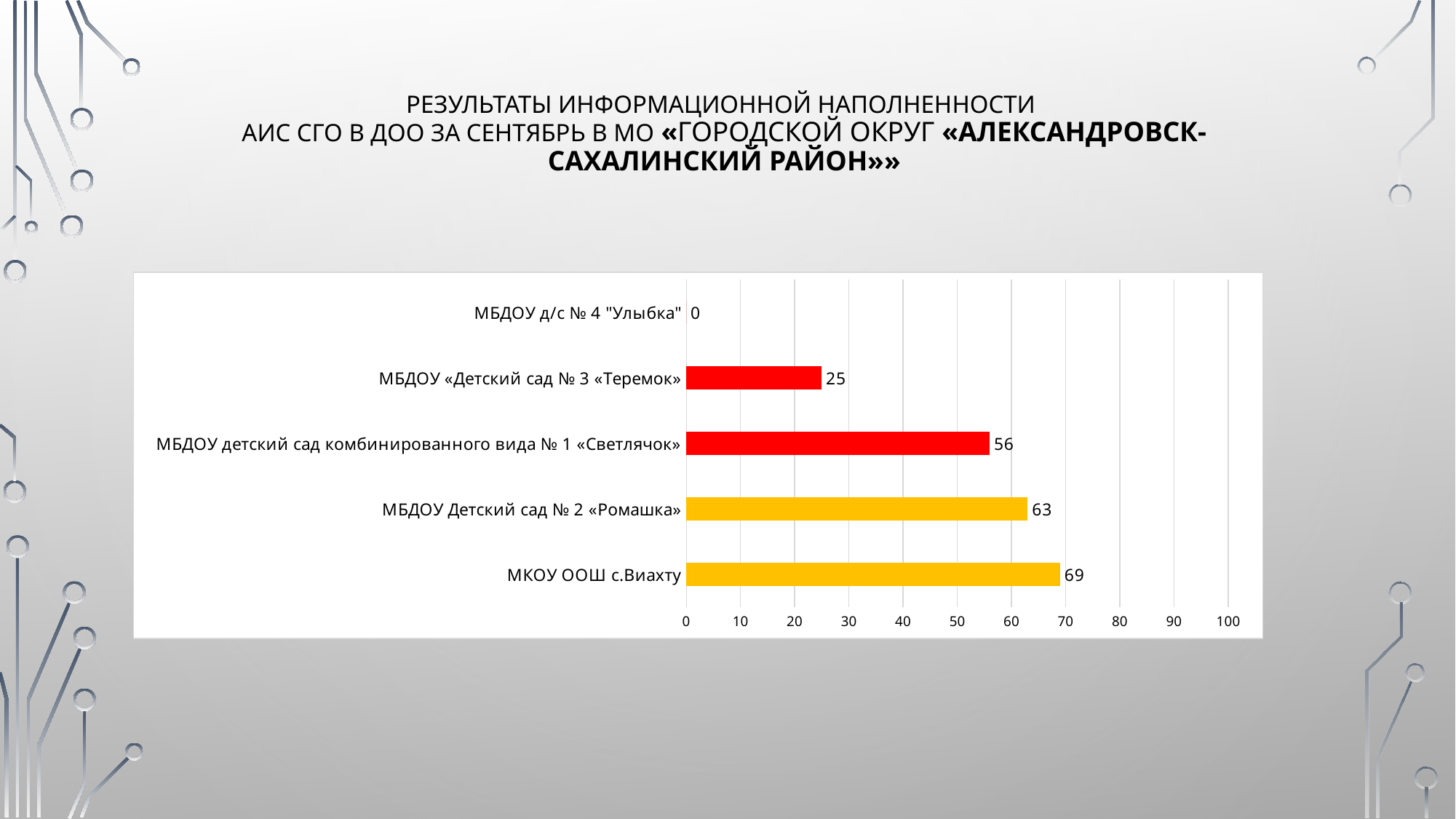
What is the maximum value shown on the horizontal axis? 100 What is the value for МБДОУ Детский сад № 2 «Ромашка»? 63 What kind of chart is shown on the slide? Bar chart Which is larger: the value for МБДОУ Детский сад № 2 «Ромашка» or the value for МБДОУ детский сад комбинированного вида № 1 «Светлячок»? МБДОУ Детский сад № 2 «Ромашка» What is the value for МБДОУ д/с № 4 "Улыбка"? 0 What is the value for МБДОУ «Детский сад № 3 «Теремок»? 25 Which category has the lowest value? МБДОУ д/с № 4 "Улыбка" Which category has the highest value? МКОУ ООШ с.Виахту What is the value for МКОУ ООШ с.Виахту? 69 What is the difference between the values for МКОУ ООШ с.Виахту and МБДОУ «Детский сад № 3 «Теремок»? 44 What is the value for МБДОУ детский сад комбинированного вида № 1 «Светлячок»? 56 How many categories are shown in the chart? 5